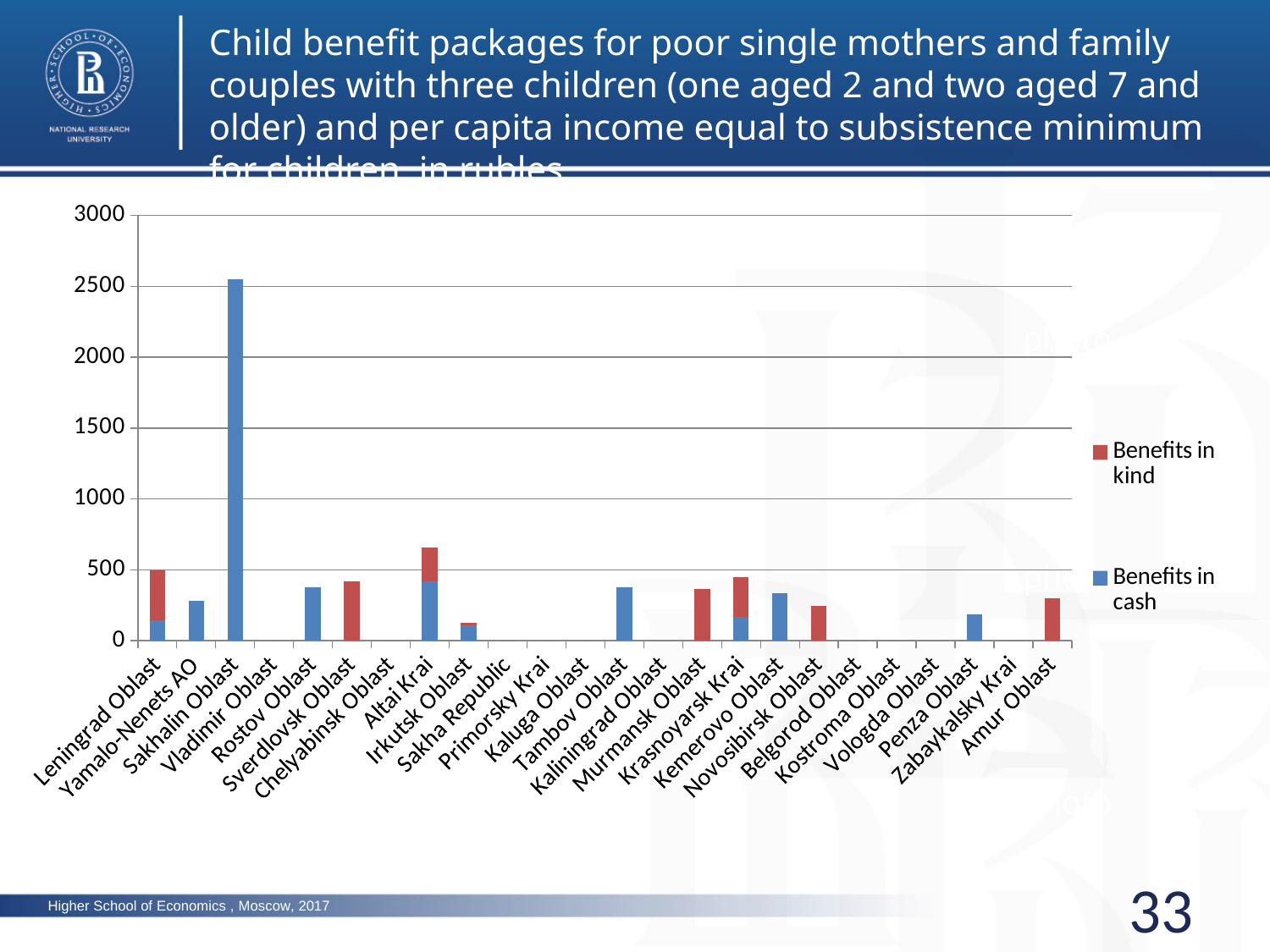
What kind of chart is shown on the slide? bar chart How many series does the legend list? 2 Is the total value for Sakhalin Oblast greater or less than 2000? greater Which has the larger total bar, Sakhalin Oblast or Altai Krai? Sakhalin Oblast What colour represents 'Benefits in kind' in the legend? red Is the total value for Altai Krai greater or less than 500? greater Which category has the highest total bar? Sakhalin Oblast Is the total value for Yamalo-Nenets AO greater or less than 500? less Which series does the bar for Sakhalin Oblast consist of entirely? Benefits in cash Which has the larger total bar, Altai Krai or Irkutsk Oblast? Altai Krai